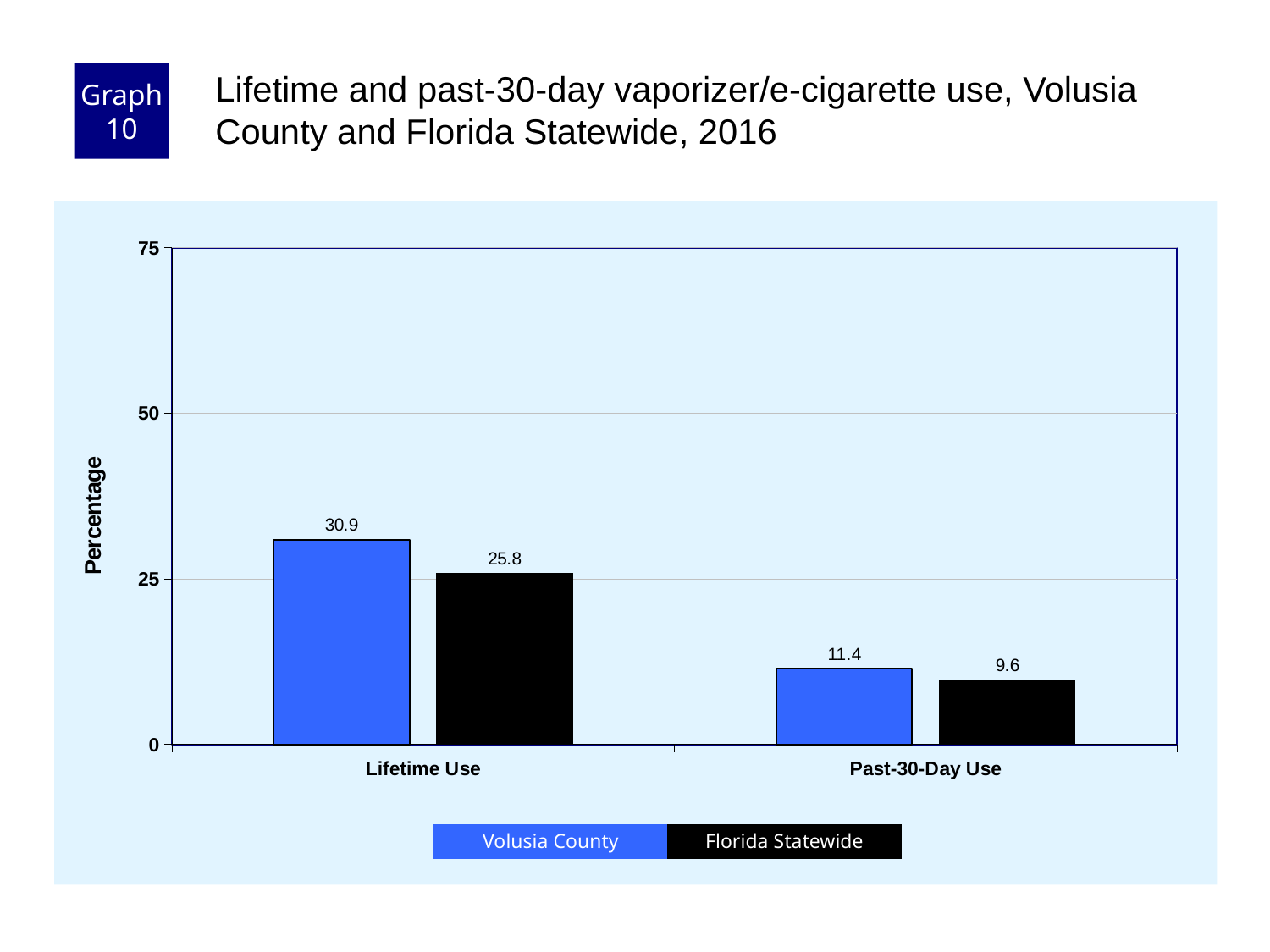
What is the Volusia County value for Lifetime Use? 30.9 How many series does the legend list? 2 What is the difference between the Volusia County and Florida Statewide values for Lifetime Use? 5.1 What is the difference between the Volusia County and Florida Statewide values for Past-30-Day Use? 1.8 Is the Volusia County value for Lifetime Use greater or less than 25? greater For Past-30-Day Use, which is larger: Volusia County or Florida Statewide? Volusia County How many categories are shown on the x axis? 2 What is the Florida Statewide value for Lifetime Use? 25.8 What kind of chart is shown on the slide? bar chart Which category has the highest Volusia County value? Lifetime Use What is the Florida Statewide value for Past-30-Day Use? 9.6 Which category has the lowest Florida Statewide value? Past-30-Day Use